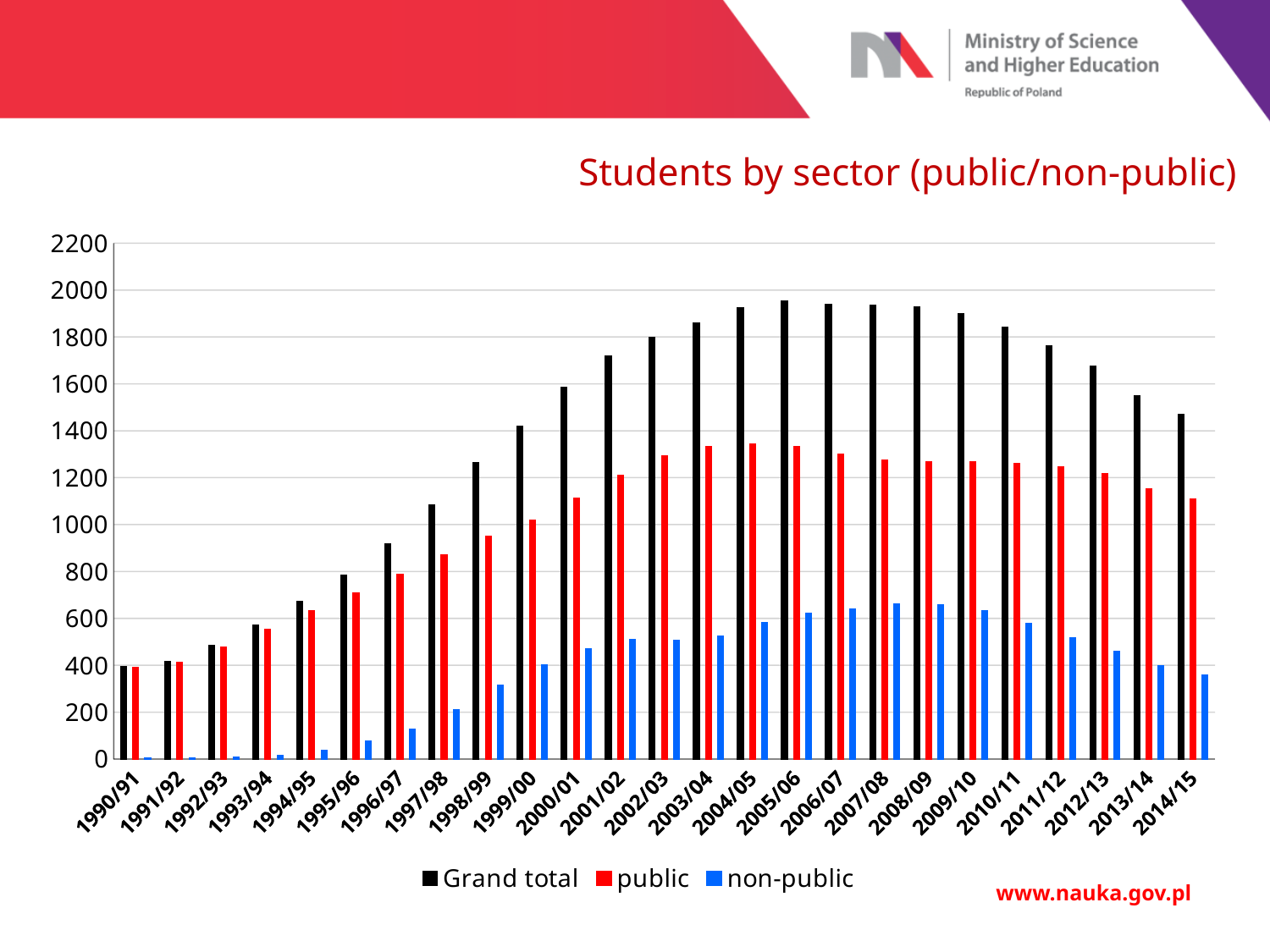
What is the title of the chart? Students by sector (public/non-public) How many series does the legend list? 3 Which is larger, the non-public value for 2005/06 or the non-public value for 2012/13? 2005/06 Which is larger, the Grand total for 2000/01 or the Grand total for 2010/11? 2010/11 Is the non-public value for 1995/96 greater or less than 200? less How many academic years are shown on the x axis? 25 Is the public value for 2014/15 greater or less than 1200? less Does the Grand total rise or fall from 1990/91 to 2005/06? rise Is the non-public value for 2007/08 greater or less than 600? greater What kind of chart is shown on the slide? bar chart